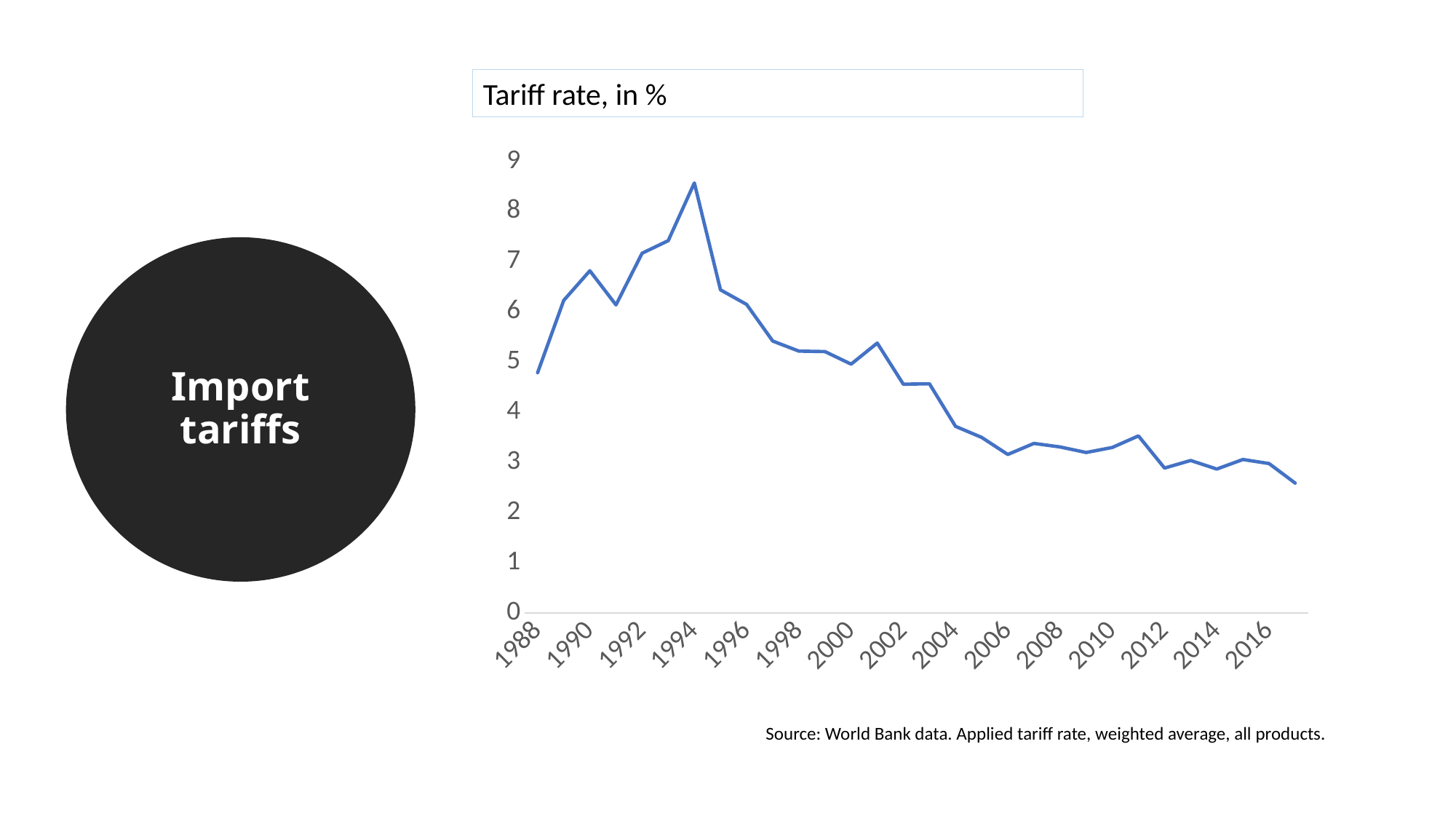
Is the tariff rate for 2004 greater or less than 4? less What kind of chart is shown on the slide? line chart Is the tariff rate for 2002 greater or less than 5? less Is the tariff rate for 2008 greater or less than 4? less In which year does the tariff rate reach its highest value? 1994 Which year has the higher tariff rate, 1994 or 2004? 1994 Which year has the higher tariff rate, 1992 or 1996? 1992 Does the tariff rate generally rise or fall from 1994 to 2016? fall What is the title of the chart? Tariff rate, in %